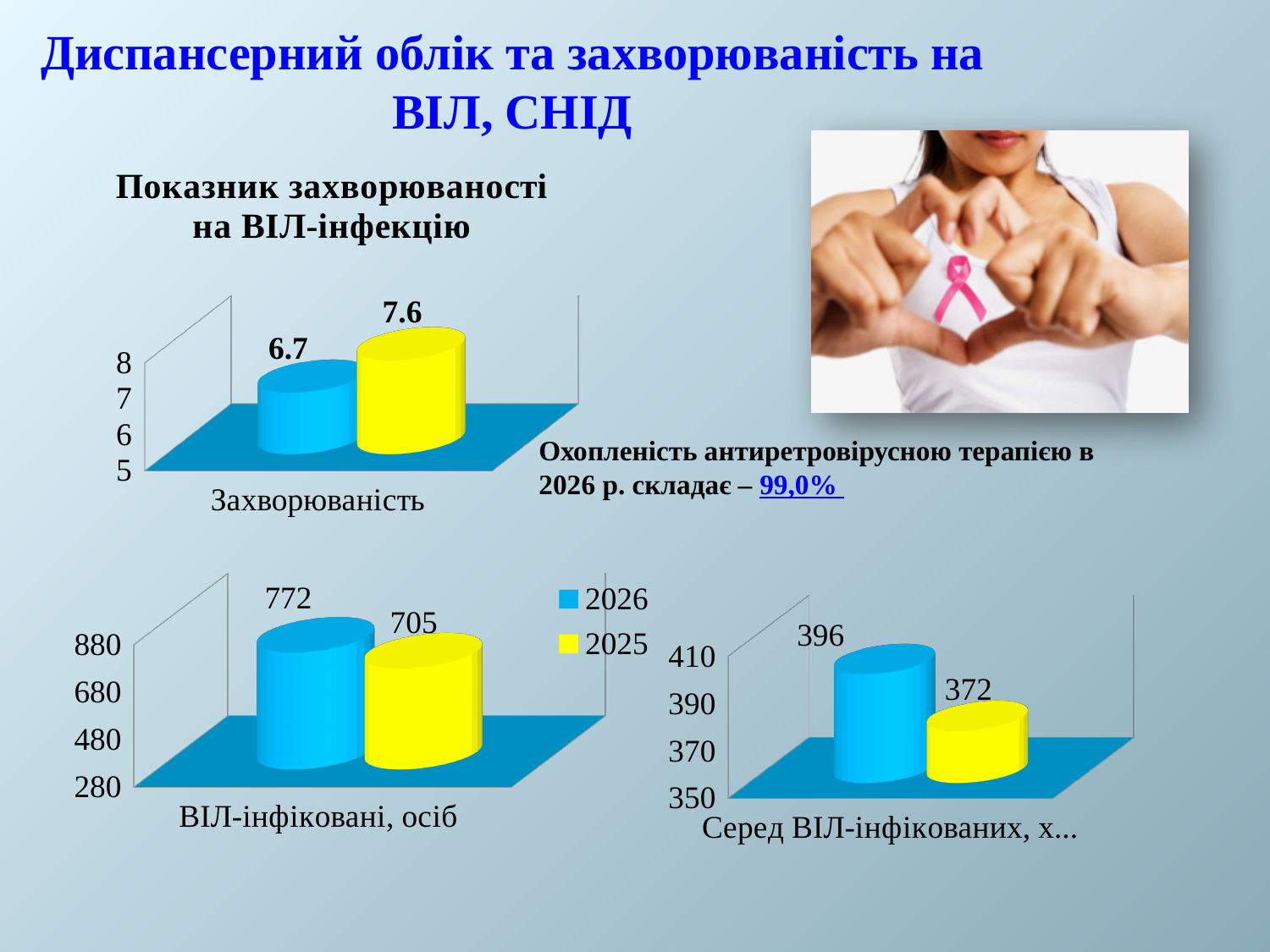
In the bottom-left chart 'ВІЛ-інфіковані, осіб', what is the value of the blue bar? 772 In the bottom-left chart 'ВІЛ-інфіковані, осіб', what is the value of the yellow bar? 705 In the bottom-right chart 'Серед ВІЛ-інфікованих, х...', what is the value of the yellow bar? 372 How many series does the legend between the bottom charts list? 2 In the bottom-left chart 'ВІЛ-інфіковані, осіб', which bar is higher, the blue one or the yellow one? the blue one In the bottom-right chart 'Серед ВІЛ-інфікованих, х...', what is the value of the blue bar? 396 In the top-left chart titled 'Показник захворюваності на ВІЛ-інфекцію', what is the value of the blue bar for 'Захворюваність'? 6.7 In the bottom-right chart 'Серед ВІЛ-інфікованих, х...', what is the difference between the blue bar (396) and the yellow bar (372)? 24 What kind of chart is the bottom-left chart 'ВІЛ-інфіковані, осіб'? bar chart In the bottom-left chart 'ВІЛ-інфіковані, осіб', what is the difference between the blue bar (772) and the yellow bar (705)? 67 In the top-left chart titled 'Показник захворюваності на ВІЛ-інфекцію', what is the value of the yellow bar for 'Захворюваність'? 7.6 In the top-left chart titled 'Показник захворюваності на ВІЛ-інфекцію', what is the difference between the yellow bar (7.6) and the blue bar (6.7)? 0.9